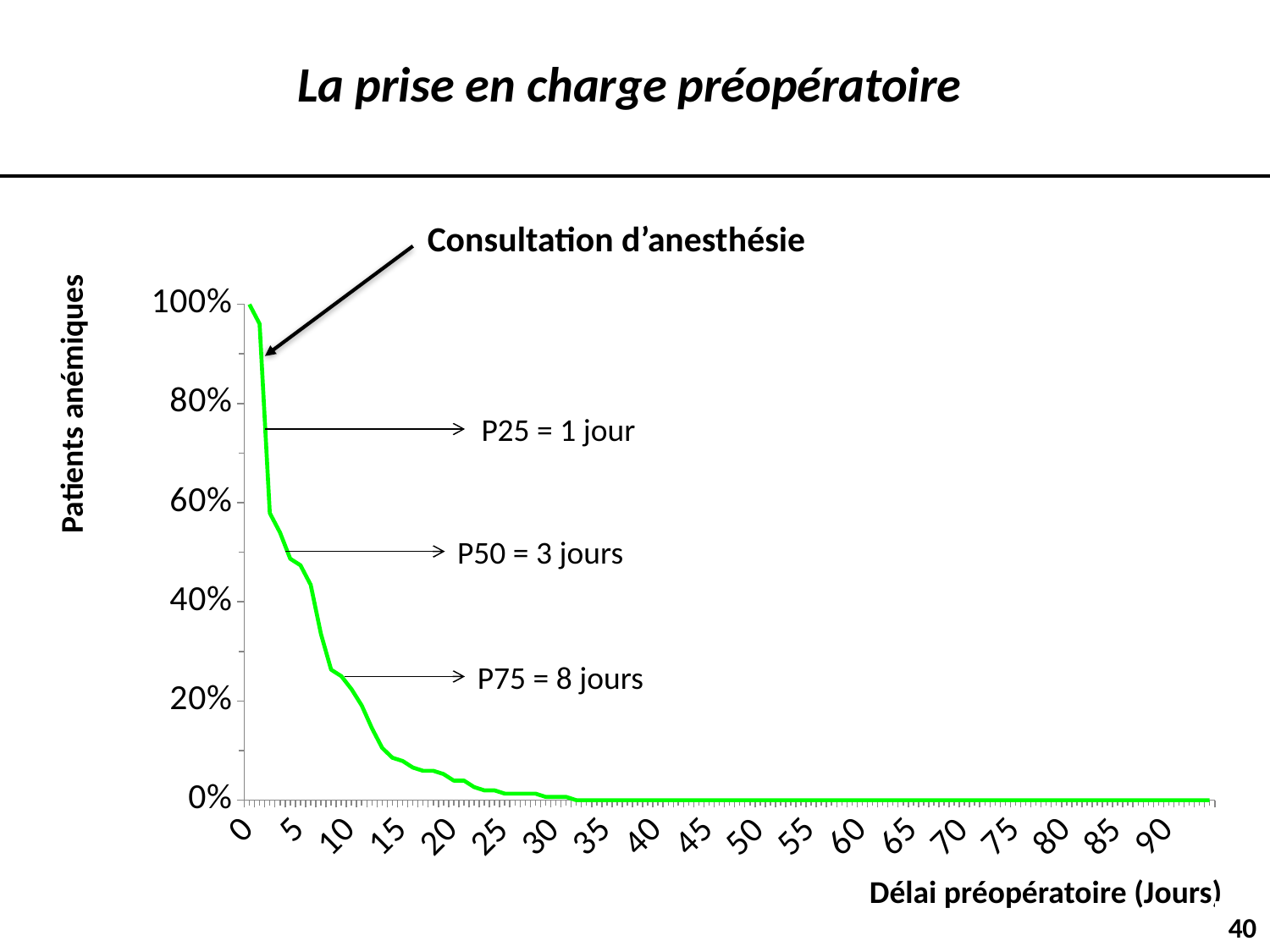
Is the value for a delay of 10 days greater or less than 40%? less Is the value for a delay of 20 days greater or less than 20%? less According to the annotation on the chart, what is the P25 value? 1 jour What kind of chart is shown on the slide? line chart At which preoperative delay is the percentage of anemic patients highest? 0 days Do the values rise or fall as the preoperative delay (Délai préopératoire) increases? fall Is the value for a delay of 1 day greater or less than 60%? greater According to the annotation on the chart, what is the P75 value? 8 jours What event does the black arrow at the start of the curve point to? Consultation d'anesthésie What is the label of the y axis? Patients anémiques According to the annotation on the chart, what is the P50 value? 3 jours